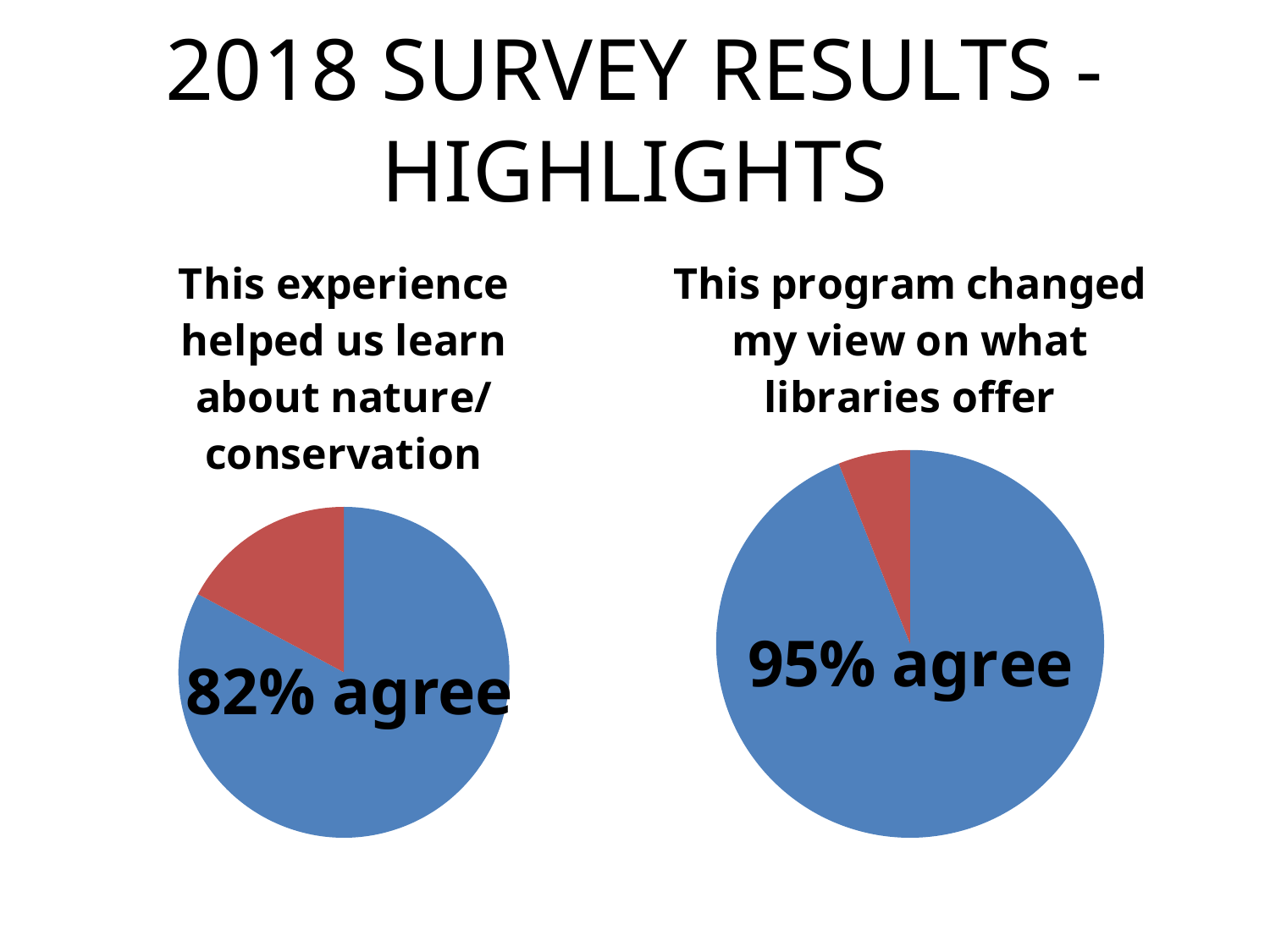
Which chart shows the higher percentage of agreement, the left one or the right one? The right one (This program changed my view on what libraries offer) How many slices does the pie chart 'This program changed my view on what libraries offer' have? 2 What is the difference in agreement between the right chart (95%) and the left chart (82%)? 13 percentage points What kind of chart is used for 'This experience helped us learn about nature/ conservation'? Pie chart In the chart 'This experience helped us learn about nature/ conservation', what percentage agree? 82% agree In the chart 'This program changed my view on what libraries offer', what percentage agree? 95% agree What is the title of the pie chart on the right side of the slide? This program changed my view on what libraries offer In the chart 'This experience helped us learn about nature/ conservation', is the blue slice larger or smaller than the red slice? larger What colour represents the 'agree' portion in both pie charts? Blue How many pie charts are shown on the slide? 2 In the chart 'This program changed my view on what libraries offer', is the red slice greater or less than 10%? less